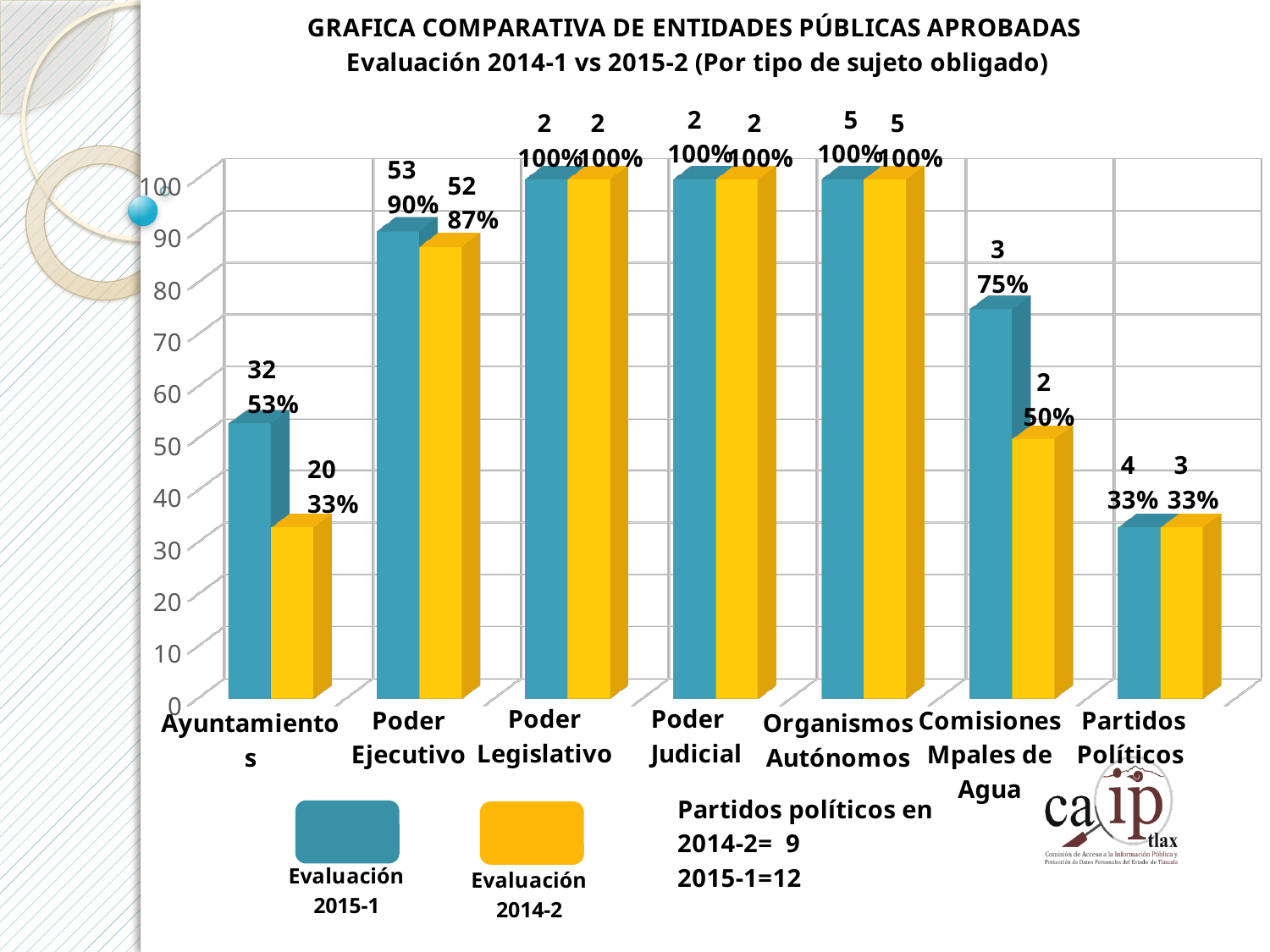
How many series does the legend list? 2 How many categories are shown on the x axis? 7 What percentage is shown for Poder Ejecutivo in the Evaluación 2015-1 series? 90% Which colour represents the Evaluación 2014-2 series? Yellow What percentage is shown for Ayuntamientos in the Evaluación 2015-1 series? 53% Is the Evaluación 2015-1 value for Partidos Políticos greater or less than 50? less What percentage is shown for Ayuntamientos in the Evaluación 2014-2 series? 33% What is the difference in percentage points between the Evaluación 2015-1 and Evaluación 2014-2 values for Comisiones Mpales de Agua? 25 What kind of chart is shown on the slide? Bar chart Which category has the lowest Evaluación 2014-2 percentage? Ayuntamientos and Partidos Políticos (tied at 33%) Which is larger for Poder Ejecutivo: the Evaluación 2015-1 value or the Evaluación 2014-2 value? Evaluación 2015-1 What percentage is shown for Comisiones Mpales de Agua in the Evaluación 2014-2 series? 50%